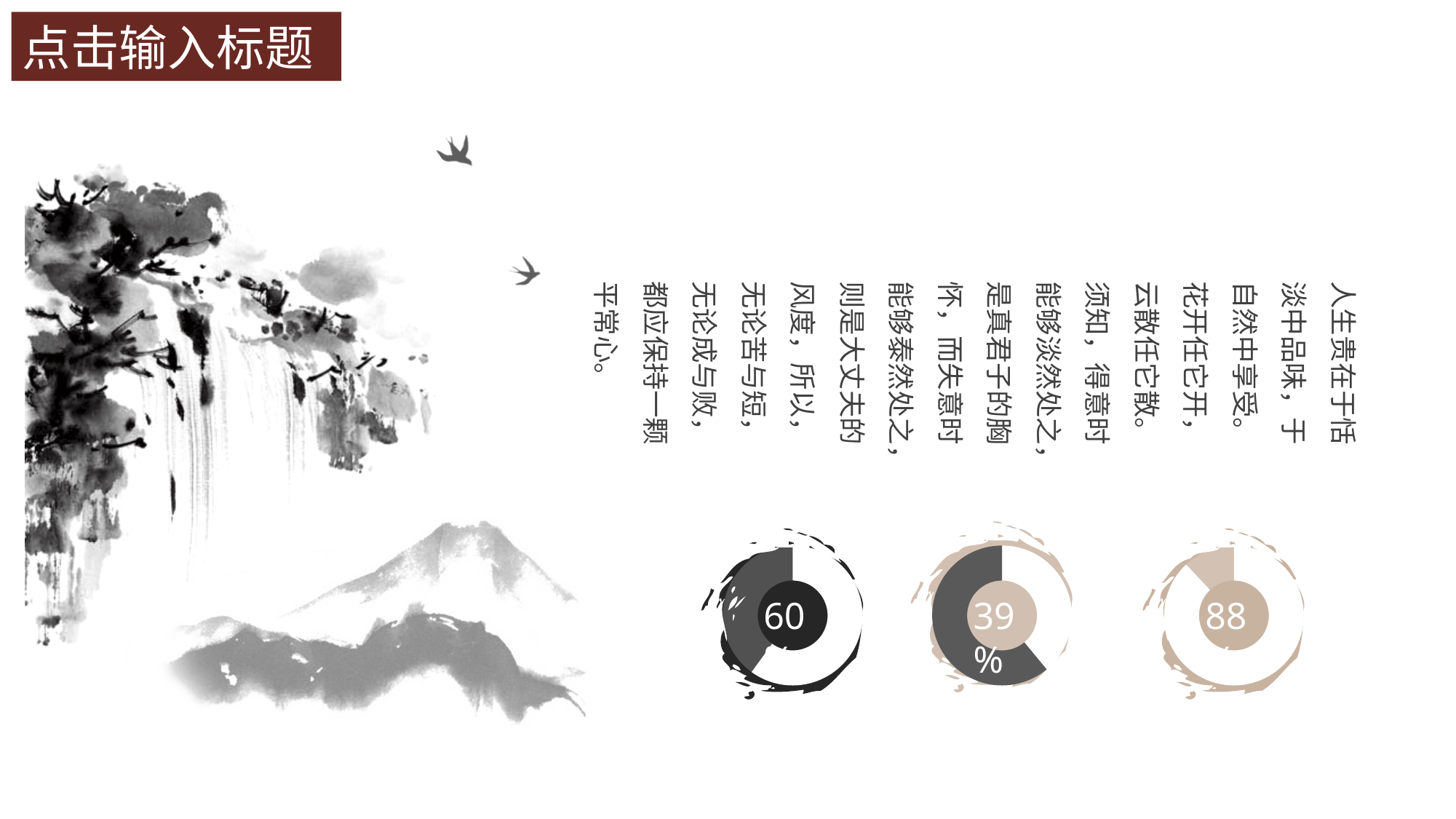
Is the printed value of the rightmost doughnut chart larger than that of the leftmost chart? Yes Which of the three doughnut charts shows the lowest printed value? The middle chart (39%) What kind of chart are the three charts at the bottom right of the slide? Doughnut chart Is the printed value of the leftmost doughnut chart larger or smaller than that of the middle chart? Larger Which of the three doughnut charts shows the highest printed value? The rightmost chart (88) What is the difference between the printed values of the rightmost and leftmost doughnut charts? 28 What value is printed in the centre of the leftmost doughnut chart? 60 What value is printed in the centre of the middle doughnut chart? 39% What value is printed in the centre of the rightmost doughnut chart? 88 What colour is the filled ring segment of the leftmost doughnut chart? Dark grey/black What colour is the filled ring segment of the rightmost doughnut chart? Tan/light brown How many doughnut charts are shown on the slide? 3